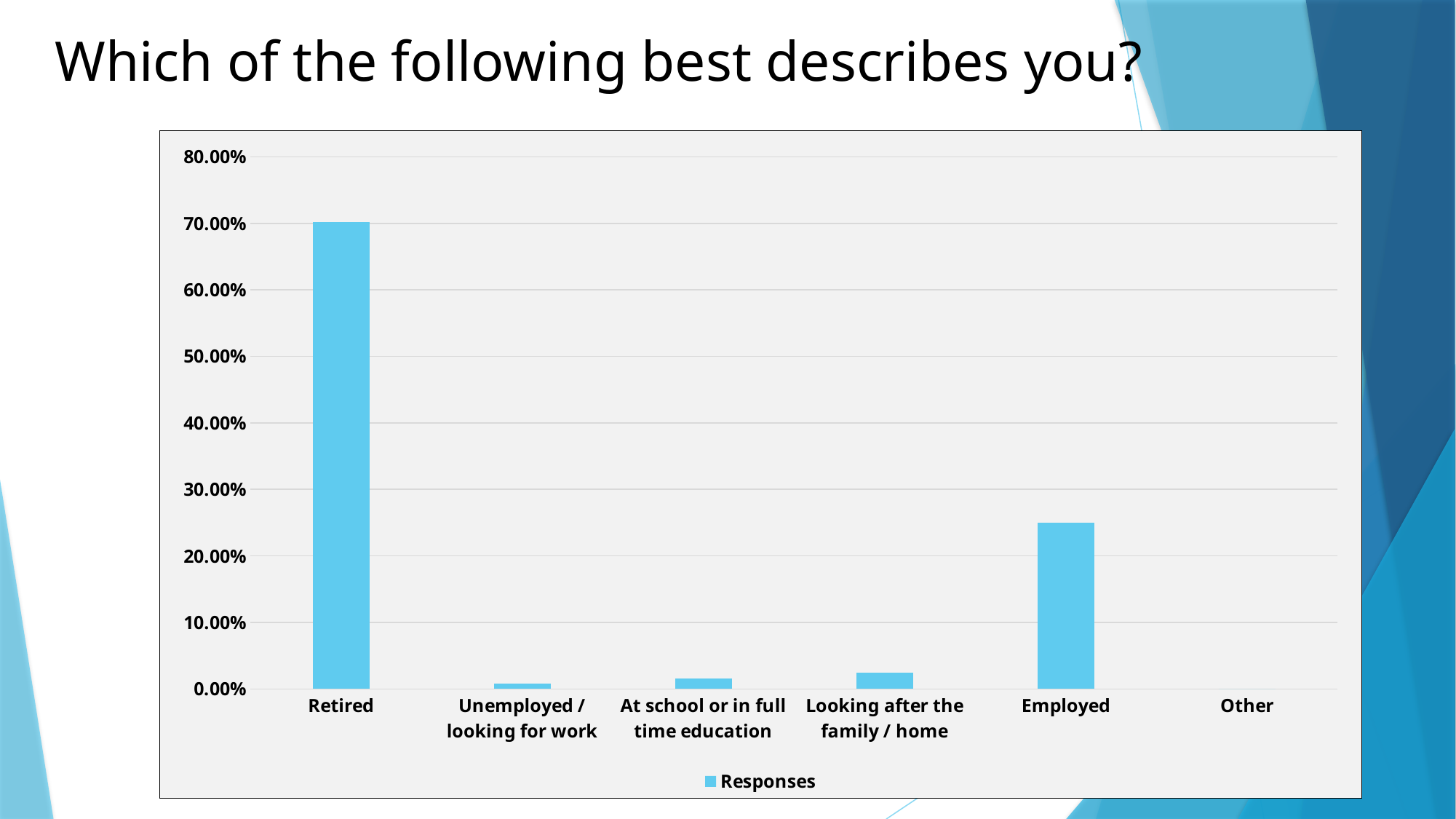
Is the value for Employed greater or less than 20.00%? greater Which category has the lowest value in the chart? Other Which has the larger value, Employed or Looking after the family / home? Employed Which category has the highest value in the chart? Retired Is the value for Unemployed / looking for work greater or less than 10.00%? less How many series does the chart's legend list? 1 Is the value for Employed greater or less than 30.00%? less What kind of chart is shown on the slide? Bar chart Which has the larger value, Retired or Employed? Retired How many categories are shown on the x axis of the chart? 6 What is the name of the series shown in the chart's legend? Responses